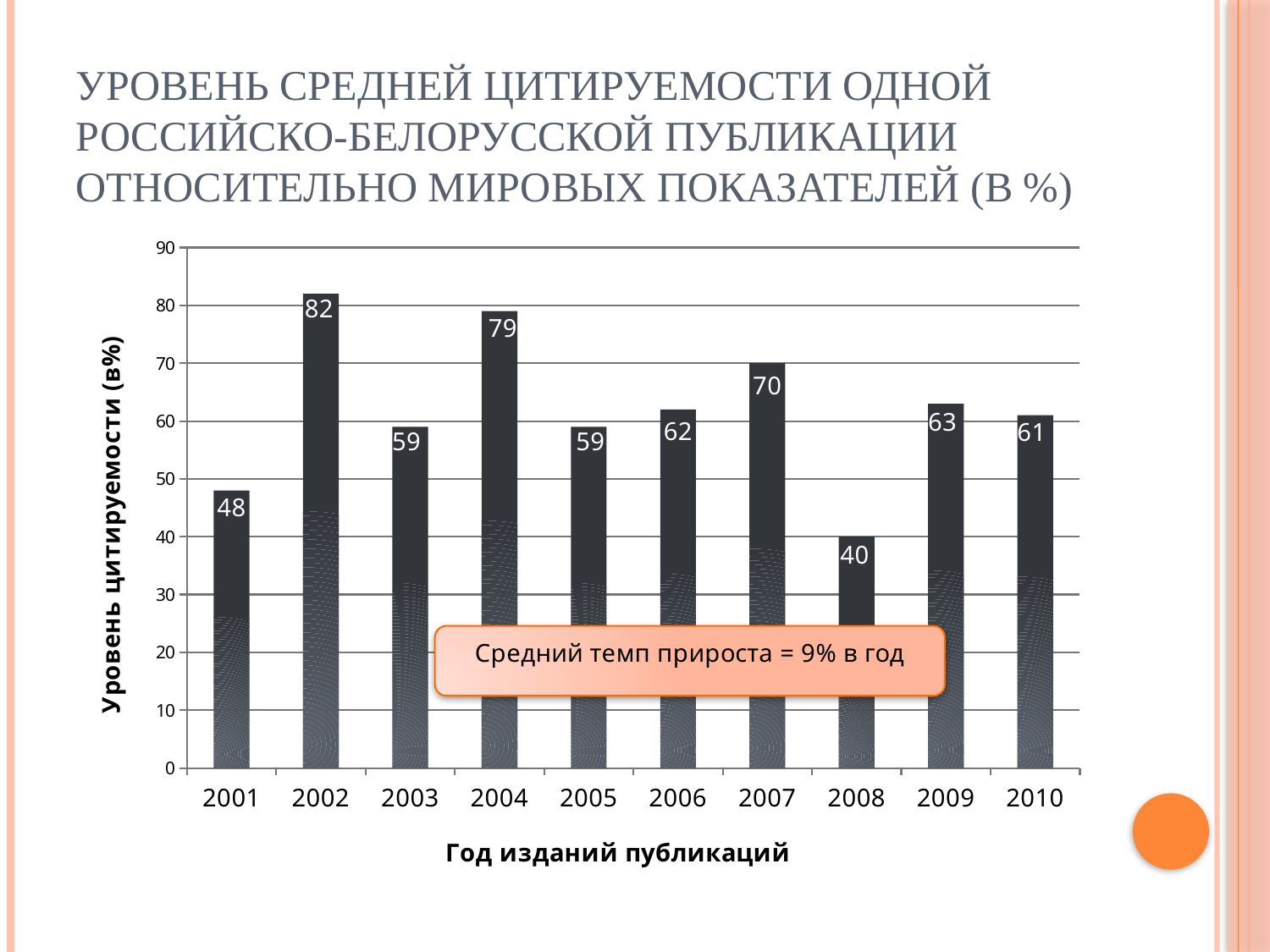
What is the value for 2008? 40 What is the x-axis title of the chart? Год изданий публикаций What kind of chart is shown on the slide? bar chart What is the value for 2010? 61 What is the value for 2002? 82 Which year has the lowest value? 2008 What is the difference between the values for 2007 and 2008? 30 Is the value for 2009 greater or less than 60? greater What is the difference between the values for 2002 and 2001? 34 How many years are shown on the x axis? 10 Which is larger, the value for 2004 or the value for 2007? 2004 Which year has the highest value? 2002